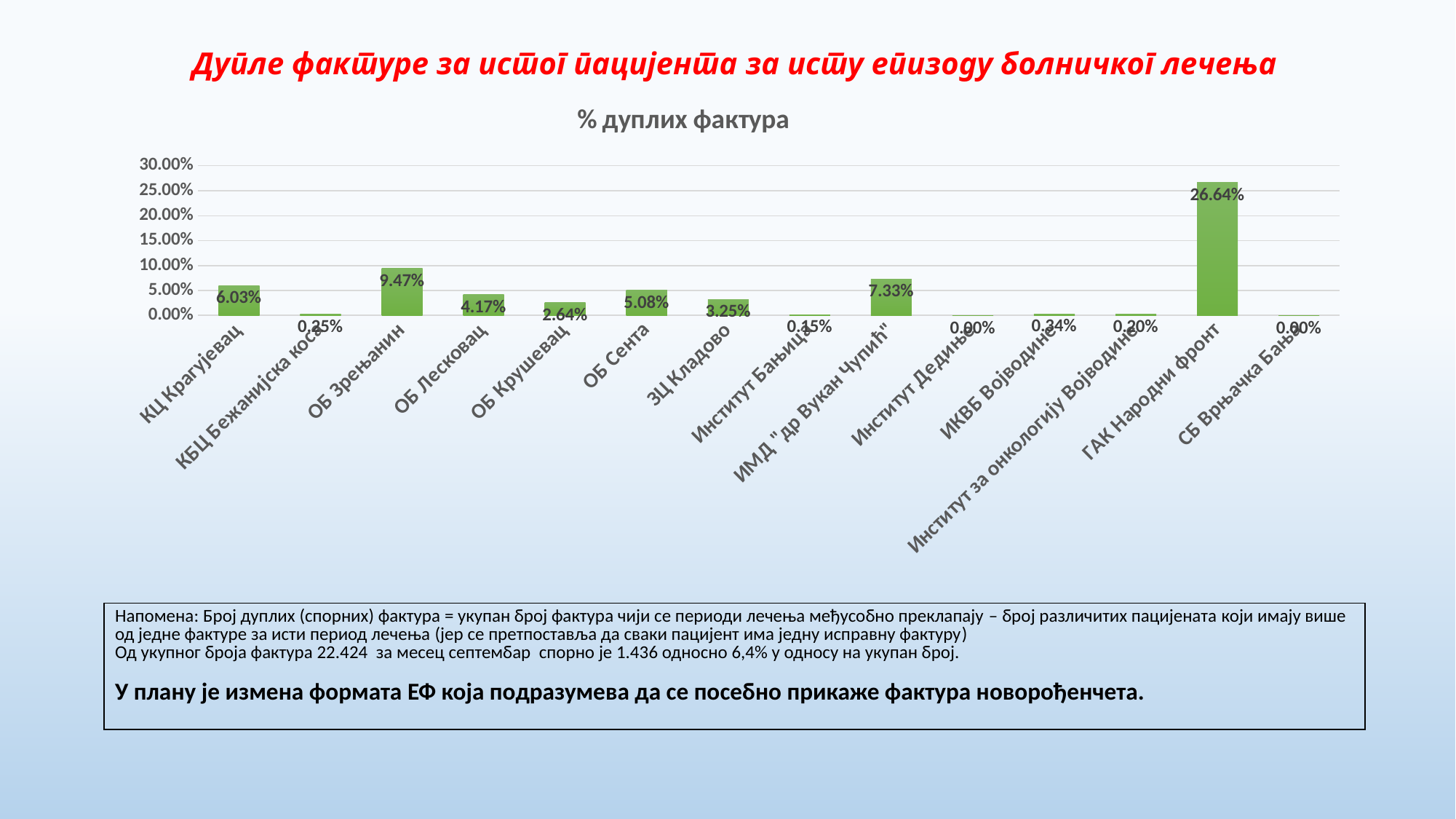
What is the value for ГАК Народни фронт? 26.64% Is the value for ГАК Народни фронт greater or less than 25.00%? greater Which is larger, the value for КЦ Крагујевац or the value for ОБ Сента? КЦ Крагујевац How many categories are shown on the x axis? 14 What is the value for ОБ Зрењанин? 9.47% What kind of chart is shown? bar chart What is the difference between the values for ОБ Зрењанин and ИМД "др Вукан Чупић"? 2.14% What is the value for ИМД "др Вукан Чупић"? 7.33% What is the value for ЗЦ Кладово? 3.25% What is the title of the chart? % дуплих фактура What is the difference between the values for ГАК Народни фронт and ОБ Зрењанин? 17.17% Which category has the highest value? ГАК Народни фронт